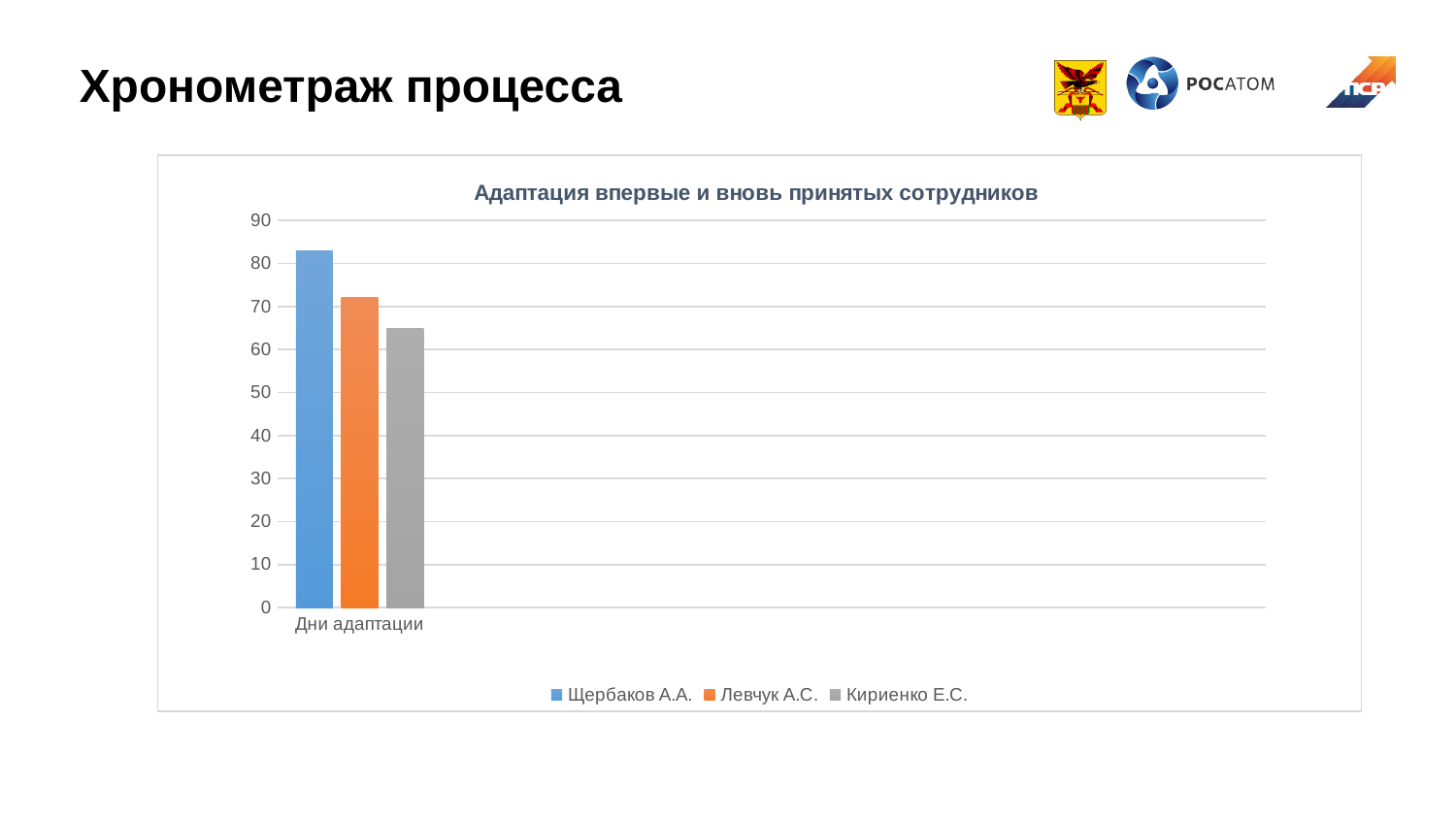
How many categories are shown on the x axis? 1 Is the value for Левчук А.С. greater or less than 80? less How many series does the legend list? 3 Is the value for Кириенко Е.С. greater or less than 70? less What kind of chart is shown on the slide? bar chart What is the title of the chart? Адаптация впервые и вновь принятых сотрудников Is the value for Щербаков А.А. greater or less than 80? greater Which is larger for Дни адаптации: Щербаков А.А. or Кириенко Е.С.? Щербаков А.А. Which is larger for Дни адаптации: Левчук А.С. or Кириенко Е.С.? Левчук А.С. What colour is the bar for Щербаков А.А.? blue Which series has the lowest value for Дни адаптации? Кириенко Е.С. Which series has the highest value for Дни адаптации? Щербаков А.А.